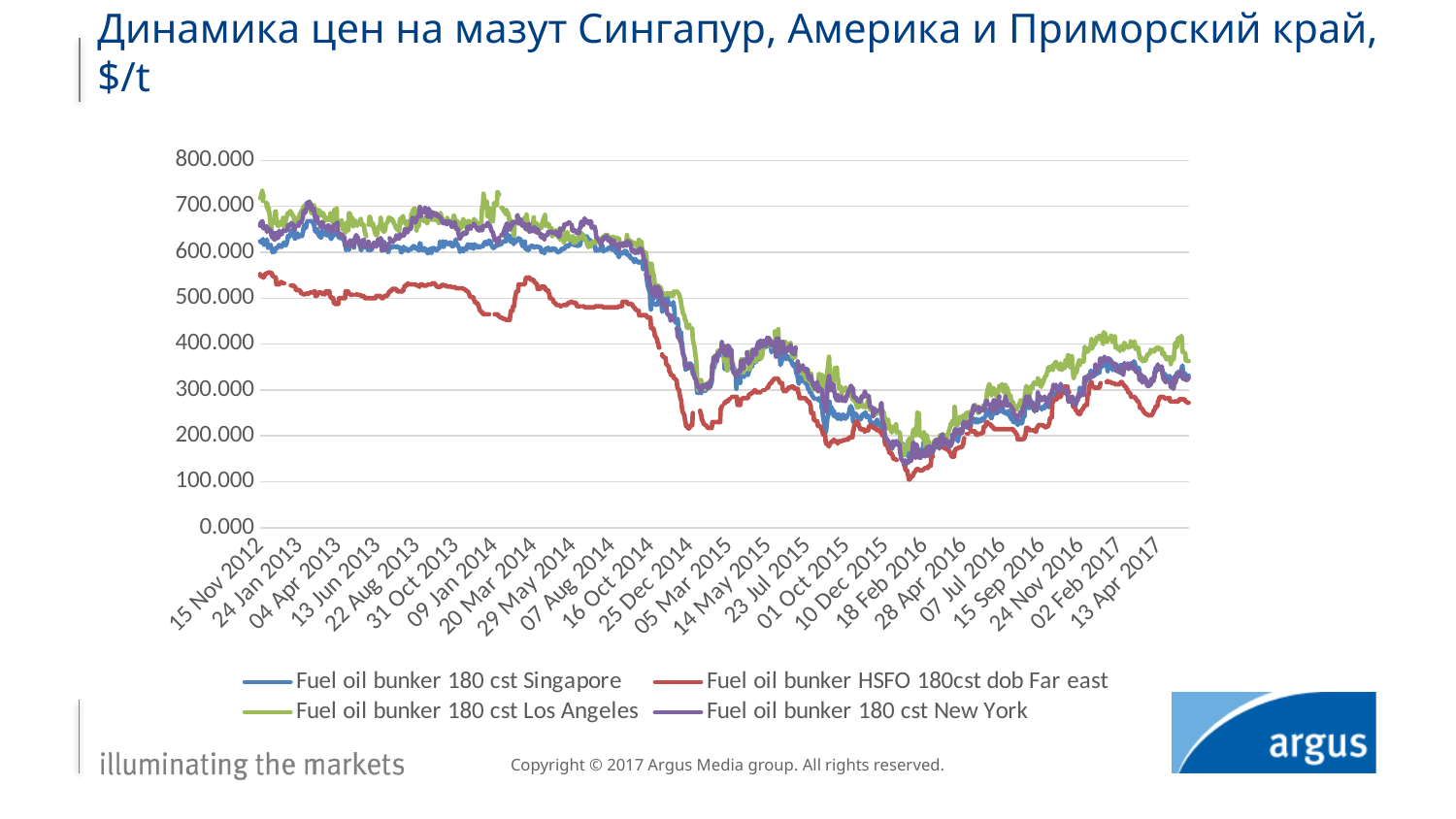
Which series has the lowest values for most of the period shown? Fuel oil bunker HSFO 180cst dob Far east What kind of chart is shown on the slide? line chart Is the value for Fuel oil bunker 180 cst Singapore at 09 Jan 2014 greater or less than 400.000? greater Is the value for Fuel oil bunker 180 cst Los Angeles at 13 Apr 2017 greater or less than 300.000? greater Which series is shown in red? Fuel oil bunker HSFO 180cst dob Far east Do the prices rise or fall between 16 Oct 2014 and 25 Dec 2014? fall How many series does the legend list? 4 At 13 Apr 2017, which is higher: Fuel oil bunker 180 cst Los Angeles or Fuel oil bunker HSFO 180cst dob Far east? Fuel oil bunker 180 cst Los Angeles Overall, do the prices rise or fall from 15 Nov 2012 to 13 Apr 2017? fall Is the lowest value of Fuel oil bunker HSFO 180cst dob Far east around 18 Feb 2016 greater or less than 200.000? less What is the highest value shown on the vertical axis? 800.000